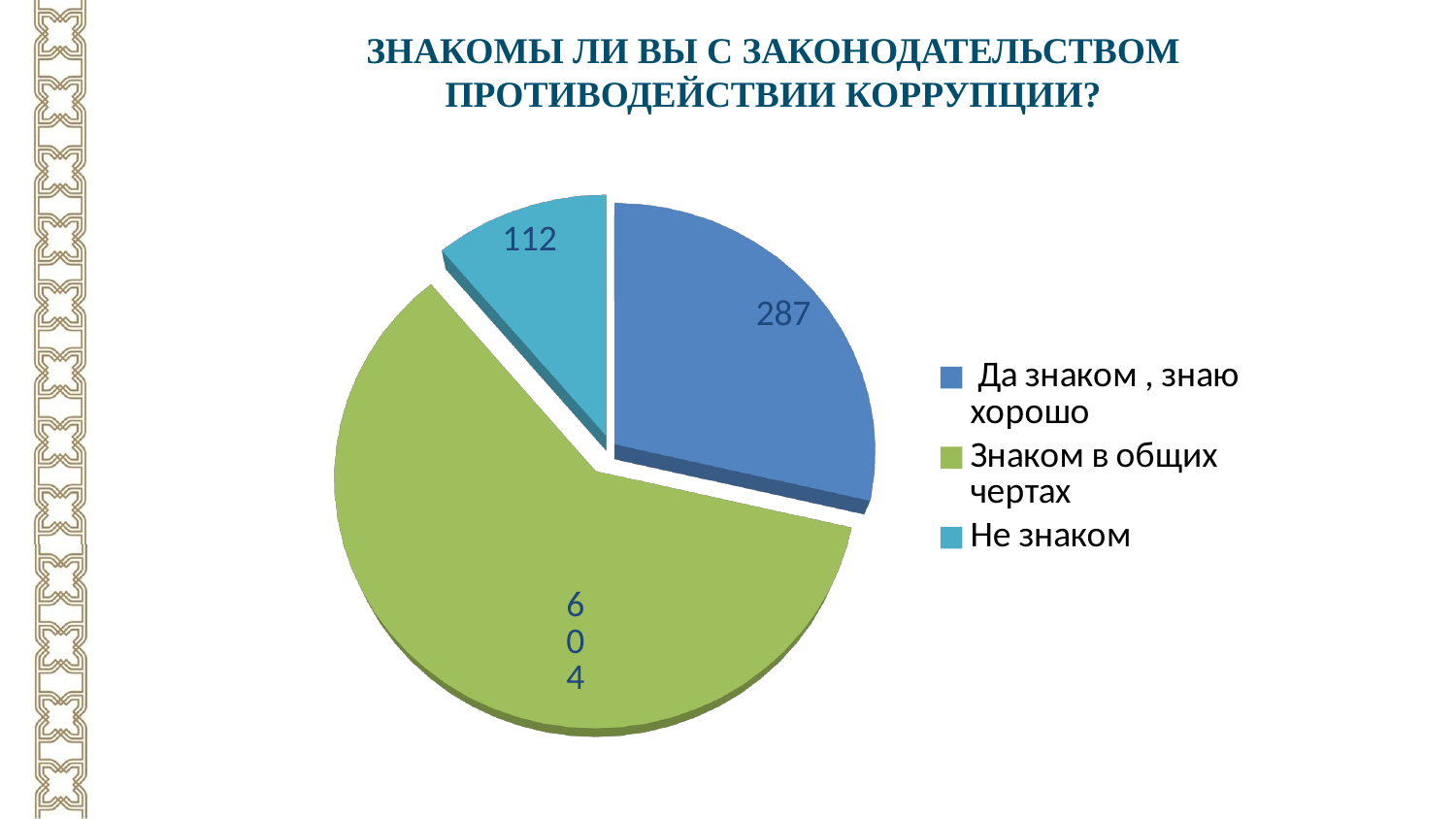
What is the difference between the values for "Да знаком, знаю хорошо" and "Не знаком"? 175 What is the total of all slices in the pie chart? 1003 What colour is the slice for "Не знаком"? teal (light blue) Which category has the largest slice of the pie? Знаком в общих чертах How many categories does the pie chart have? 3 What is the difference between the values for "Знаком в общих чертах" and "Да знаком, знаю хорошо"? 317 What type of chart is shown on the slide? pie chart Which is larger: the value for "Да знаком, знаю хорошо" or the value for "Не знаком"? Да знаком, знаю хорошо What is the value for "Знаком в общих чертах"? 604 What is the value for "Не знаком"? 112 Which category has the smallest slice of the pie? Не знаком What is the value for "Да знаком, знаю хорошо"? 287